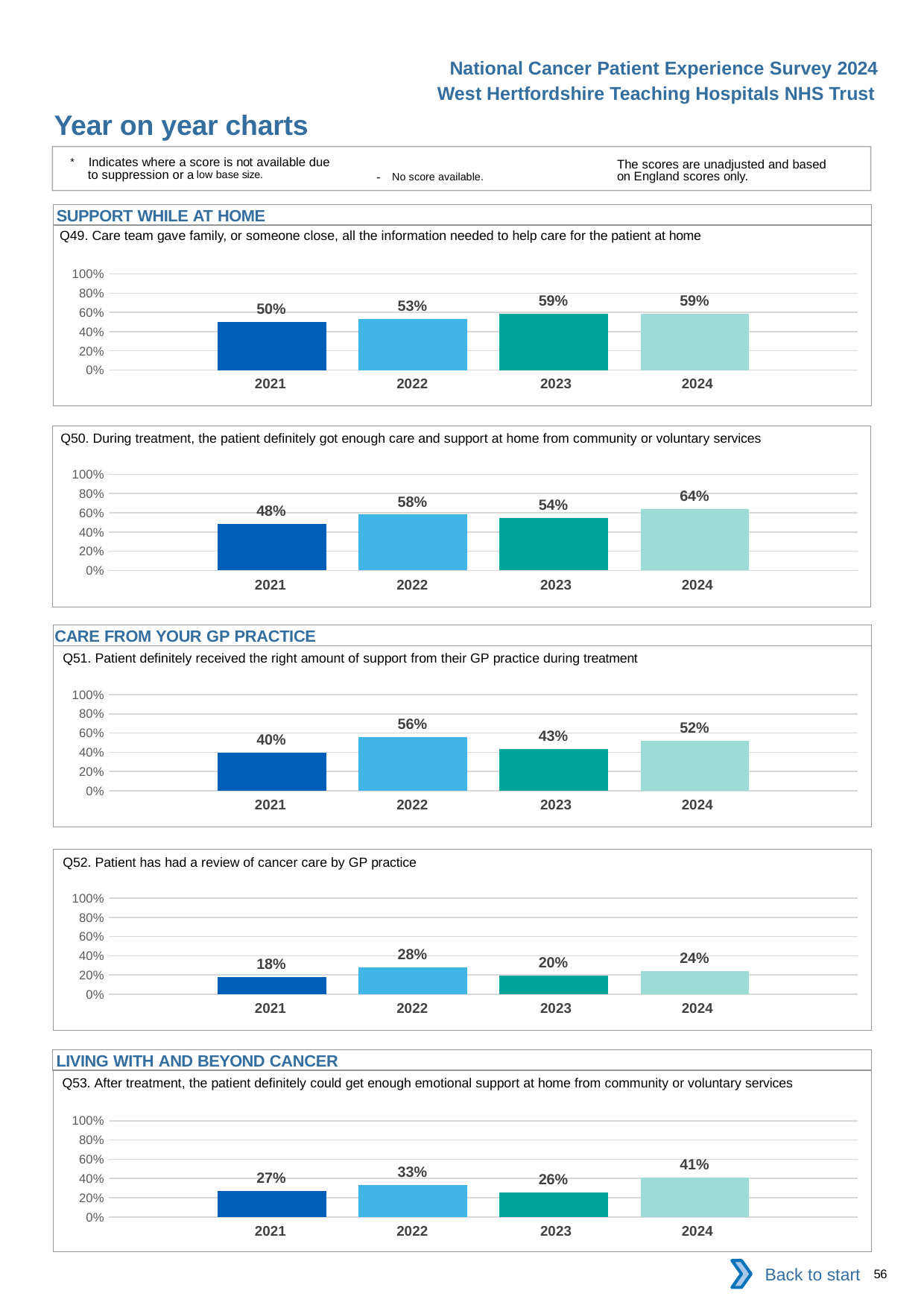
In the Q52 chart, is the value for 2022 greater or less than 40%? less In the Q51 chart, which year has the lowest value? 2021 In the Q49 chart, what is the value for 2022? 53% In the Q51 chart, which is larger, the value for 2022 or the value for 2024? 2022 What kind of chart is the Q50 chart? Bar chart In the Q50 chart, what is the difference between the 2024 and 2021 values? 16 percentage points How many years are plotted in the Q49 chart? 4 In the Q53 chart, what is the difference between the 2022 and 2023 values? 7 percentage points In the Q50 chart, which year has the highest value? 2024 In the Q53 chart, what is the value for 2024? 41% In the Q49 chart, do the values rise or fall from 2021 to 2023? Rise In the Q52 chart, what is the value for 2023? 20%